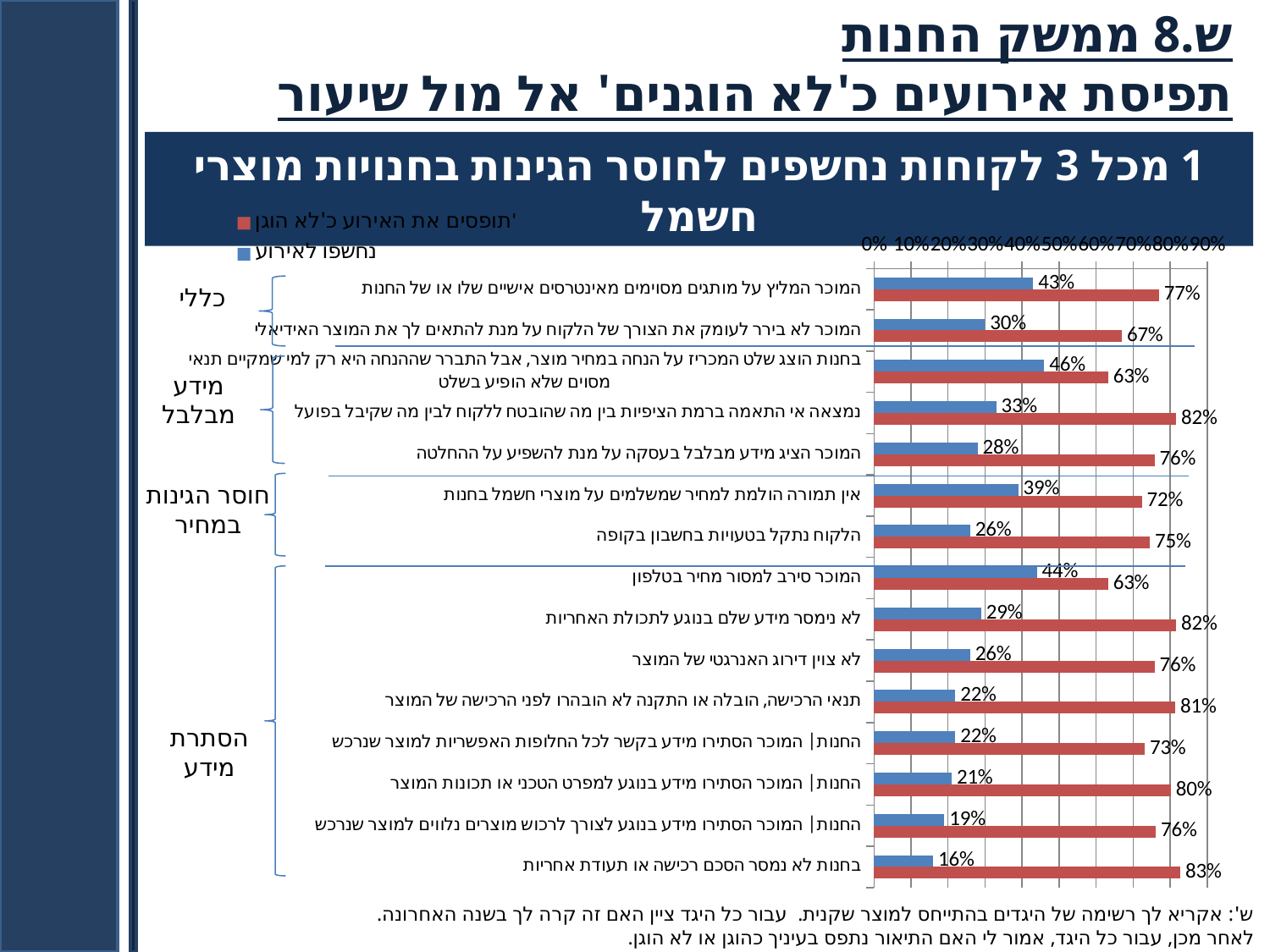
Which category has the lowest value in the 'נחשפו לאירוע' series? בחנות לא נמסר הסכם רכישה או תעודת אחריות What is the difference between the two series for 'המוכר המליץ על מותגים מסוימים מאינטרסים אישיים שלו או של החנות'? 34% What is the value of the 'נחשפו לאירוע' series for 'בחנות לא נמסר הסכם רכישה או תעודת אחריות'? 16% How many series does the chart's legend list? 2 What type of chart is shown on the slide? bar chart Which colour represents the 'נחשפו לאירוע' series? blue How many categories (statements) are plotted in the chart? 15 What is the value of the 'תופסים את האירוע כ'לא הוגן'' series for 'נמצאה אי התאמה ברמת הציפיות בין מה שהובטח ללקוח לבין מה שקיבל בפועל'? 82% What is the value of the 'נחשפו לאירוע' series for 'המוכר סירב למסור מחיר בטלפון'? 44% For 'אין תמורה הולמת למחיר שמשלמים על מוצרי חשמל בחנות', which series has the larger value? תופסים את האירוע כ'לא הוגן' Which category has the highest value in the 'תופסים את האירוע כ'לא הוגן'' series? בחנות לא נמסר הסכם רכישה או תעודת אחריות Which category has the highest value in the 'נחשפו לאירוע' series? בחנות הוצג שלט המכריז על הנחה במחיר מוצר, אבל התברר שההנחה היא רק למי שמקיים תנאי מסוים שלא הופיע בשלט